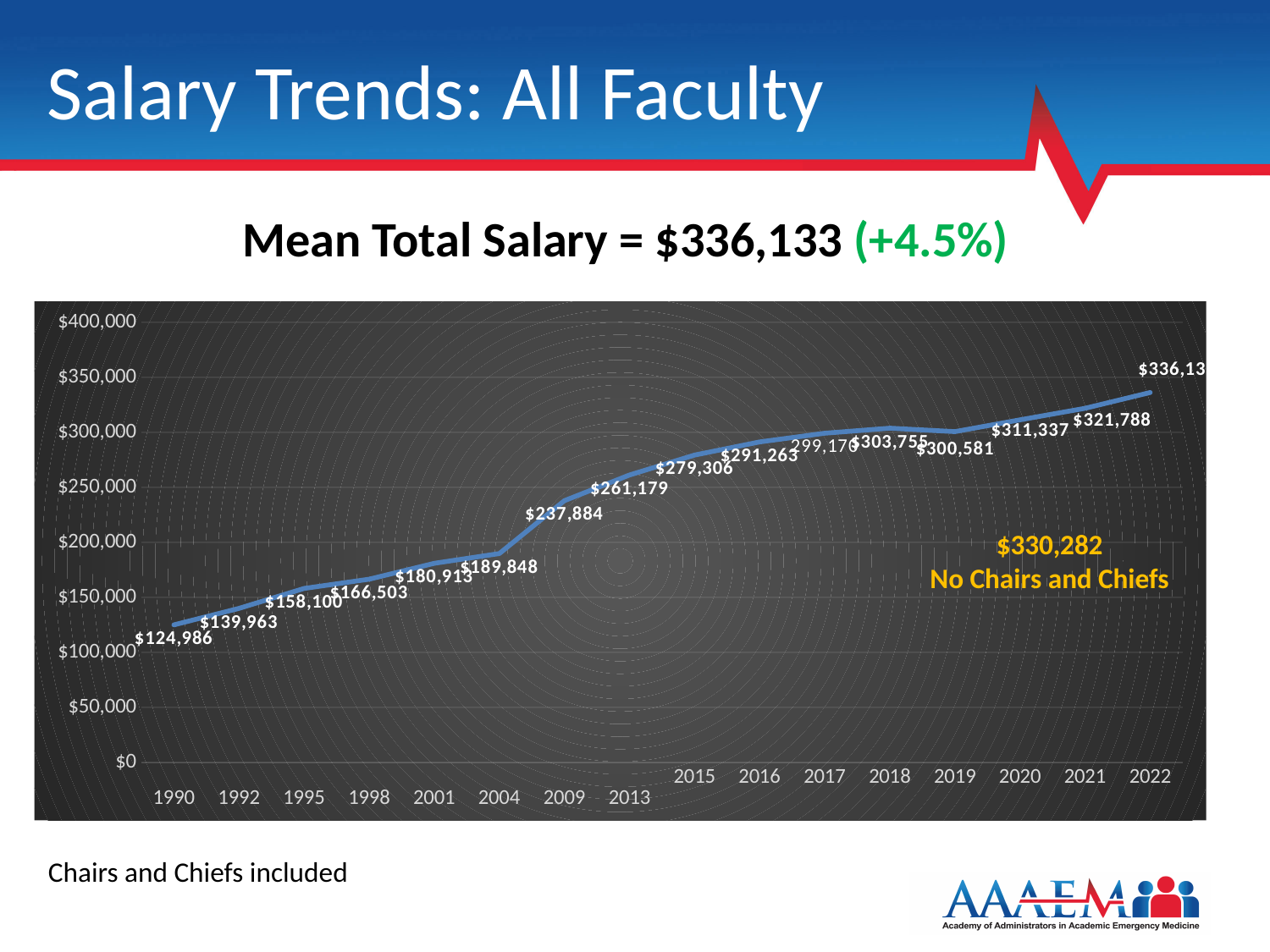
Is the mean total salary for 2018 or 2019 larger? 2018 What type of chart is shown on the slide? line chart What is the mean total salary plotted for 2019? $300,581 What is the mean total salary plotted for 2009? $237,884 Does the mean total salary generally rise or fall from 1990 to 2022? rise Is the value for 2013 greater or less than $250,000? greater What is the mean total salary plotted for 2021? $321,788 What is the difference between the mean total salary in 2021 and in 2020? $10,451 Which year has the highest mean total salary on the chart? 2022 What is the mean total salary plotted for 1990? $124,986 Which year has the lowest mean total salary on the chart? 1990 How many years are plotted on the x axis of the chart? 16